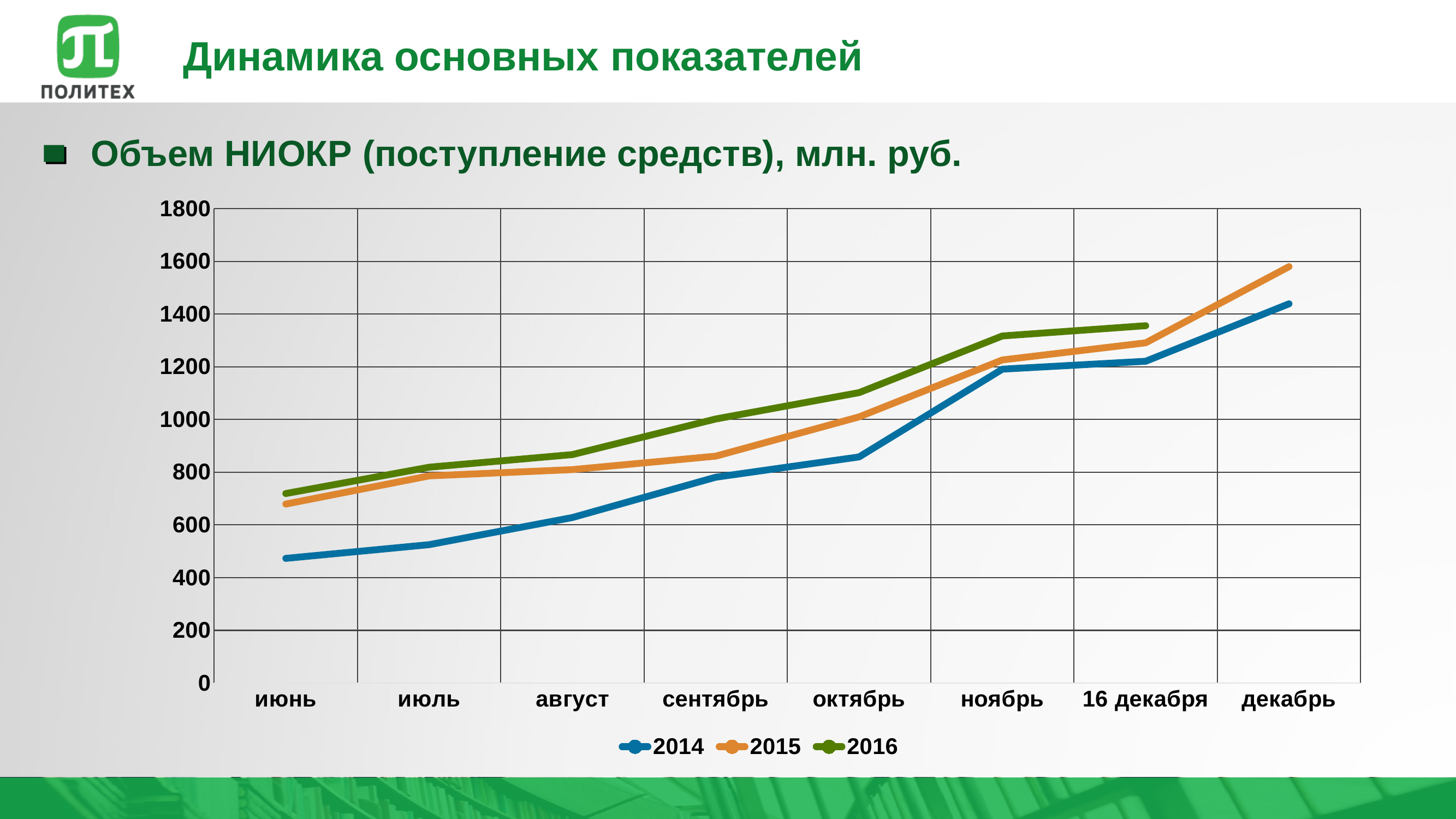
Is the value for 2015 in декабрь greater or less than 1400? greater Is the value for 2015 in июнь greater or less than 600? greater Do the values for 2014 rise or fall from июнь to декабрь? rise In декабрь, which series has the larger value, 2014 or 2015? 2015 What kind of chart is shown on the slide? line chart Which series are listed in the legend? 2014, 2015, 2016 How many categories are shown on the x axis? 8 Is the value for 2014 in июнь greater or less than 600? less In июнь, which series has the larger value, 2014 or 2016? 2016 What is the title of the chart? Объем НИОКР (поступление средств), млн. руб. How many series does the legend list? 3